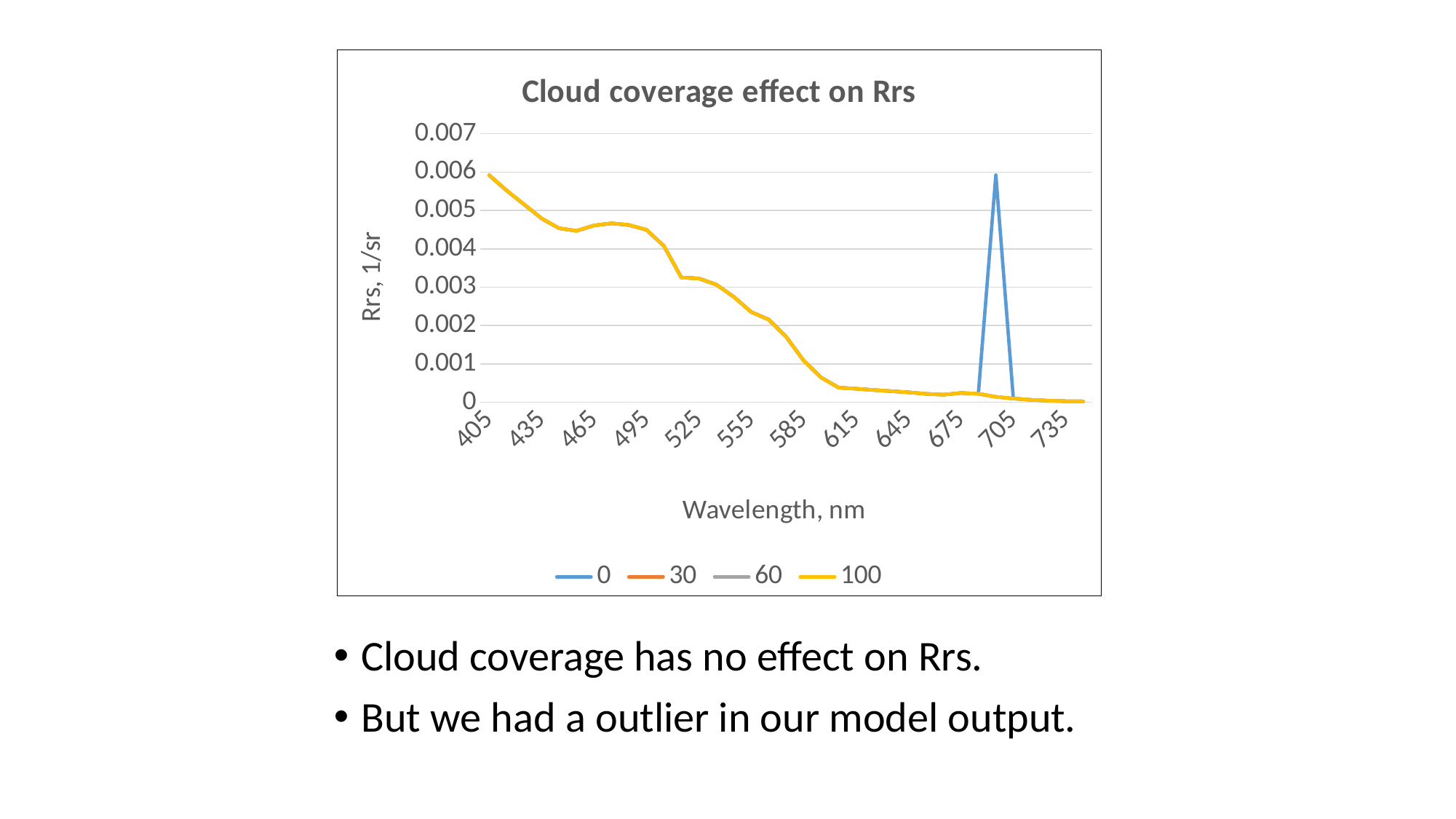
Do the Rrs values generally rise or fall as wavelength increases from 405 nm to 735 nm? fall Is the value of the 100 series at 735 nm greater or less than 0.001? less How many wavelength tick labels are shown on the x axis? 12 What is the label of the x axis? Wavelength, nm Is the value of the 100 series at 465 nm greater or less than 0.004? greater How many series does the legend list? 4 What kind of chart is shown on the slide? line chart What is the title of the chart? Cloud coverage effect on Rrs Is the value of the 100 series at 585 nm greater or less than 0.002? less